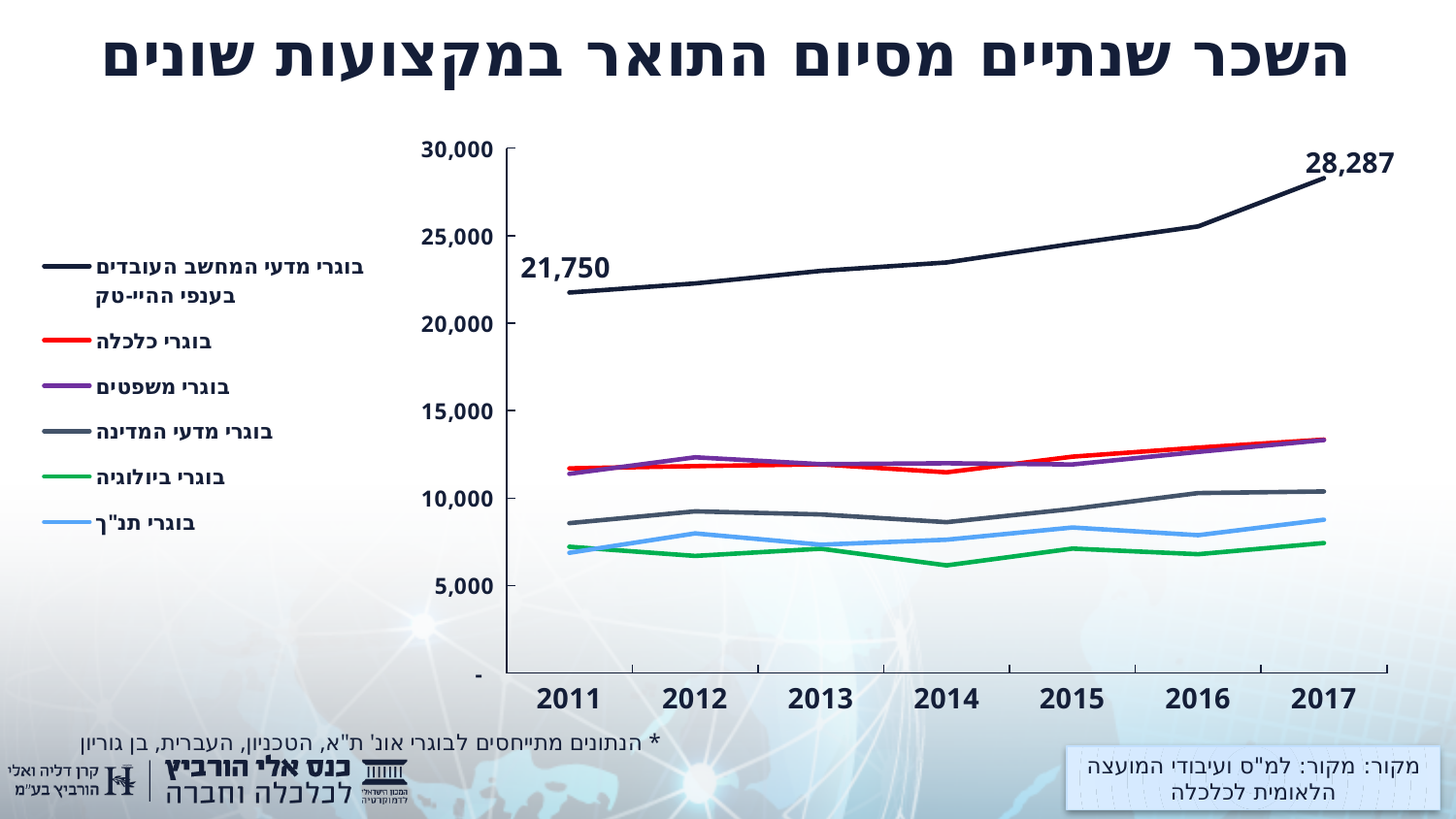
Does the value for בוגרי מדעי המחשב העובדים בענפי ההיי-טק rise or fall from 2011 to 2017? Rise Is the value for בוגרי ביולוגיה in 2014 greater or less than 10,000? less How many years are shown on the x axis? 7 What kind of chart is shown on the slide? Line chart Is the value for בוגרי מדעי המחשב העובדים בענפי ההיי-טק in 2016 greater or less than 25,000? greater Which series has the highest value in 2017? בוגרי מדעי המחשב העובדים בענפי ההיי-טק By how much did the value for בוגרי מדעי המחשב העובדים בענפי ההיי-טק increase from 2011 to 2017? 6,537 What is the value for בוגרי מדעי המחשב העובדים בענפי ההיי-טק in 2017? 28,287 How many series does the legend list? 6 What is the value for בוגרי מדעי המחשב העובדים בענפי ההיי-טק in 2011? 21,750 Which series has the lowest value in 2014? בוגרי ביולוגיה Which is larger in 2017: the value for בוגרי מדעי המדינה or the value for בוגרי ביולוגיה? בוגרי מדעי המדינה